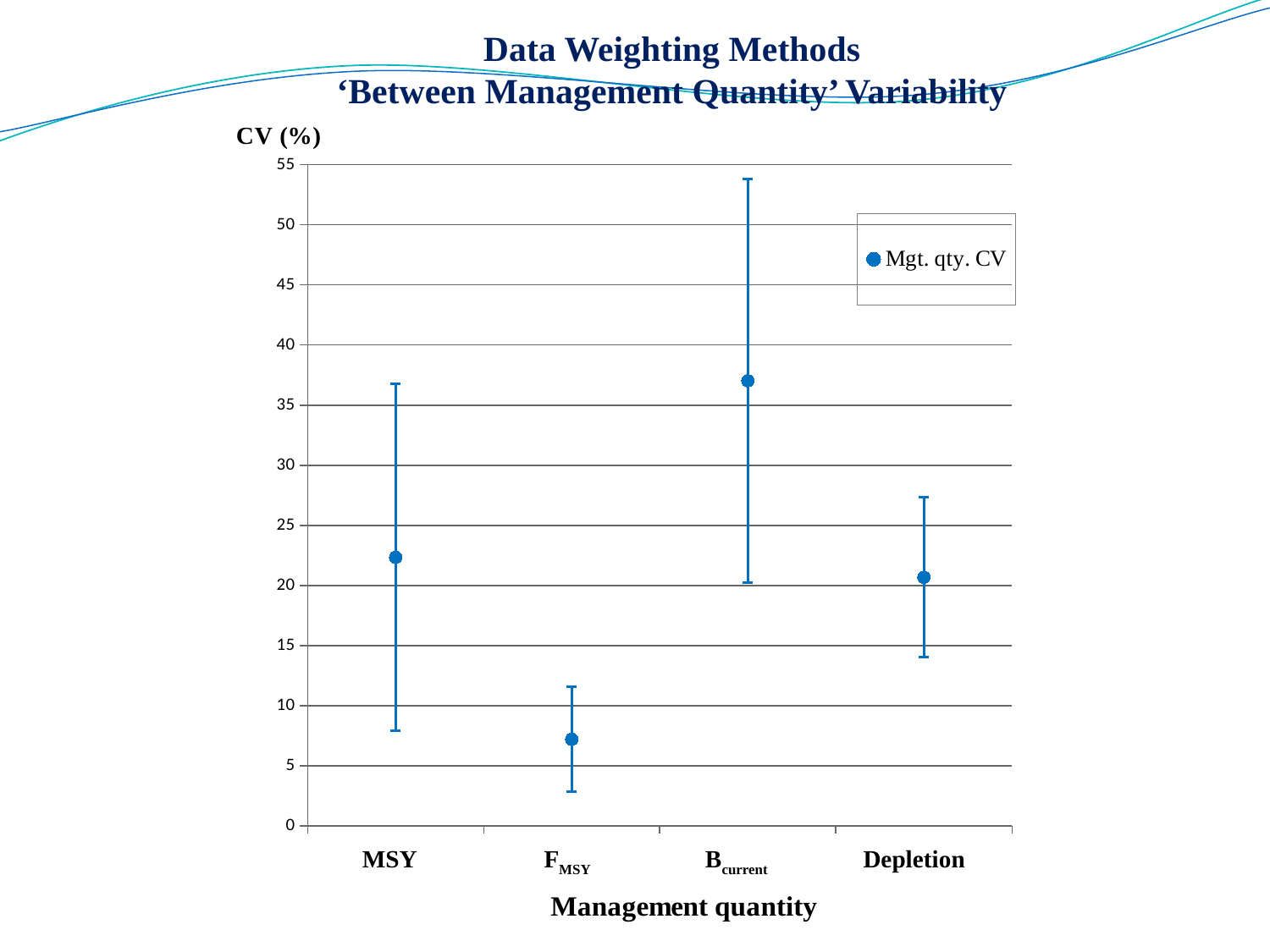
Is the CV (%) value for Bcurrent greater or less than 35? greater Is the CV (%) value for FMSY greater or less than 10? less Which has a larger CV (%), FMSY or Depletion? Depletion How many management quantities are plotted on the x axis? 4 Which has a larger CV (%), Bcurrent or MSY? Bcurrent What is the series name shown in the legend? Mgt. qty. CV Which management quantity has the lowest CV (%)? FMSY Which management quantity has the highest CV (%)? Bcurrent Is the CV (%) value for MSY greater or less than 20? greater What kind of chart is shown on the slide? Scatter chart with error bars How many series does the legend list? 1